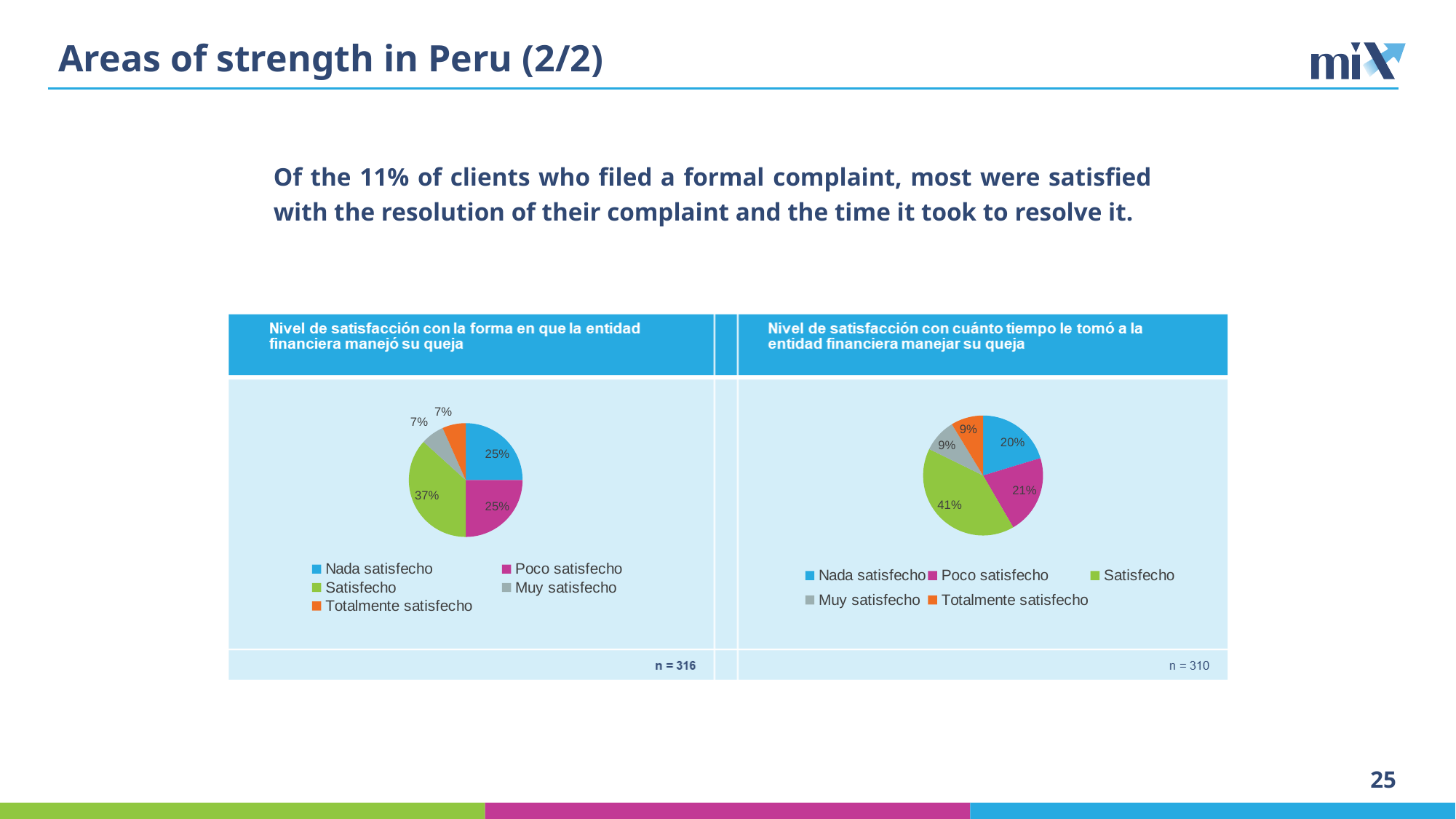
In the right pie chart, what is the difference between the Satisfecho share and the Nada satisfecho share? 21% In the left pie chart, what share of respondents answered Nada satisfecho? 25% In the left pie chart, what is the difference between the Satisfecho share and the Muy satisfecho share? 30% In the left pie chart, which category has the largest slice? Satisfecho In the left pie chart, what share of respondents answered Satisfecho? 37% In the right pie chart, what share of respondents answered Poco satisfecho? 21% In the right pie chart, which category has the largest slice? Satisfecho In the right pie chart, what share of respondents answered Muy satisfecho? 9% How many categories does the legend of the right pie chart list? 5 What type of chart is used on the left side of the slide? Pie chart In the left pie chart, which is larger: the Satisfecho slice or the Poco satisfecho slice? Satisfecho What sample size (n) is shown below the right pie chart? n = 310